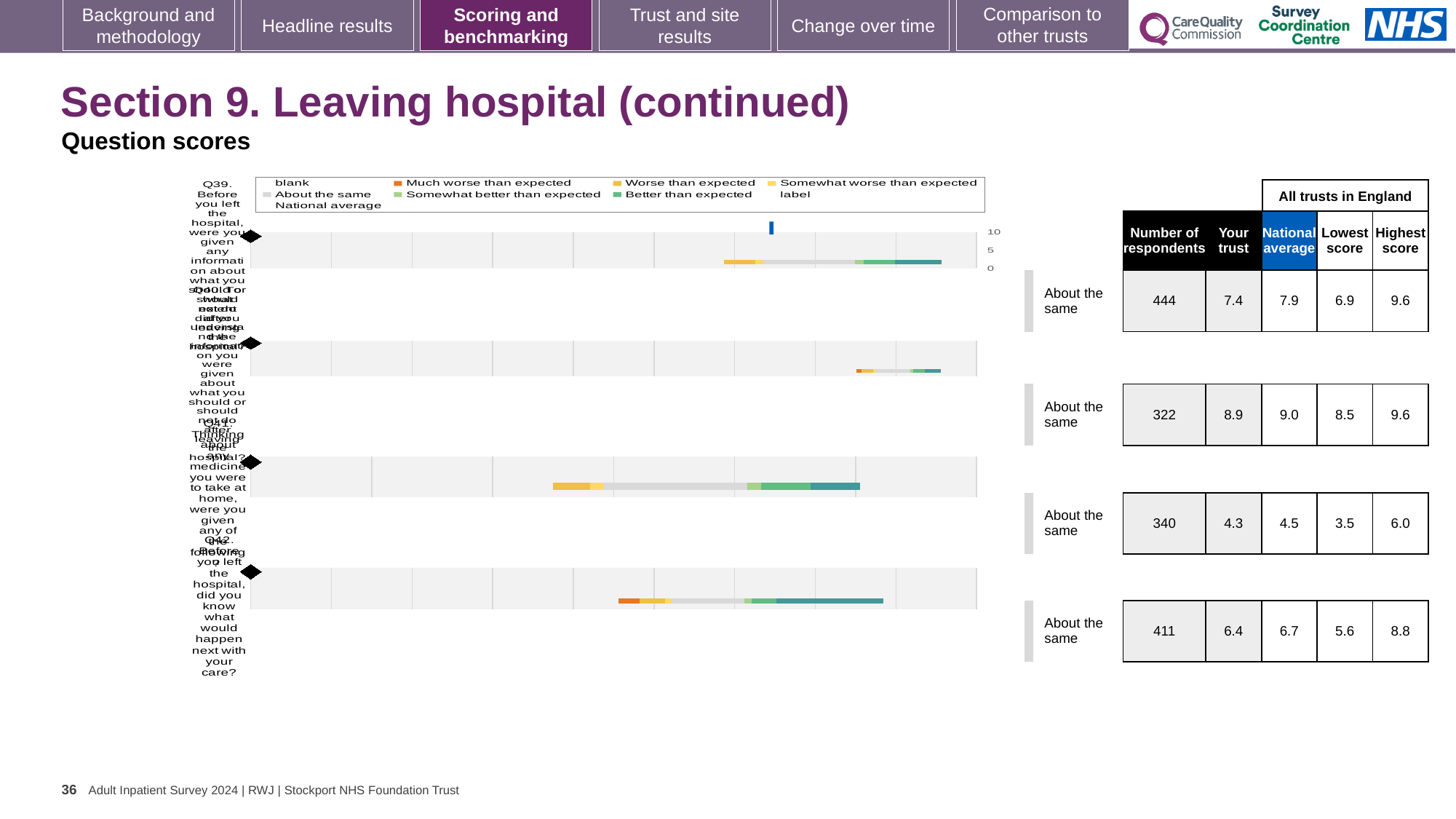
What kind of chart is shown on the slide? bar chart What benchmark category is shown for every row in the chart? About the same What is the difference between the national average and the 'Your trust' score for the first row (Q39)? 0.5 What is the 'Your trust' score for the first row (Q39)? 7.4 How many question rows (bars) does the chart show? 4 What is the national average for the second row (Q40)? 9.0 What is the highest score across all trusts in England for the last row (Q42)? 8.8 For the last row (Q42), which is larger: the 'Your trust' score or the national average? National average How many respondents are listed for the third row (Q41)? 340 Which row has the lowest 'Your trust' score? Q41 (third row), 4.3 Is the 'Your trust' score for the third row (Q41) greater or less than 5? less Which row has the highest 'Your trust' score? Q40 (second row), 8.9